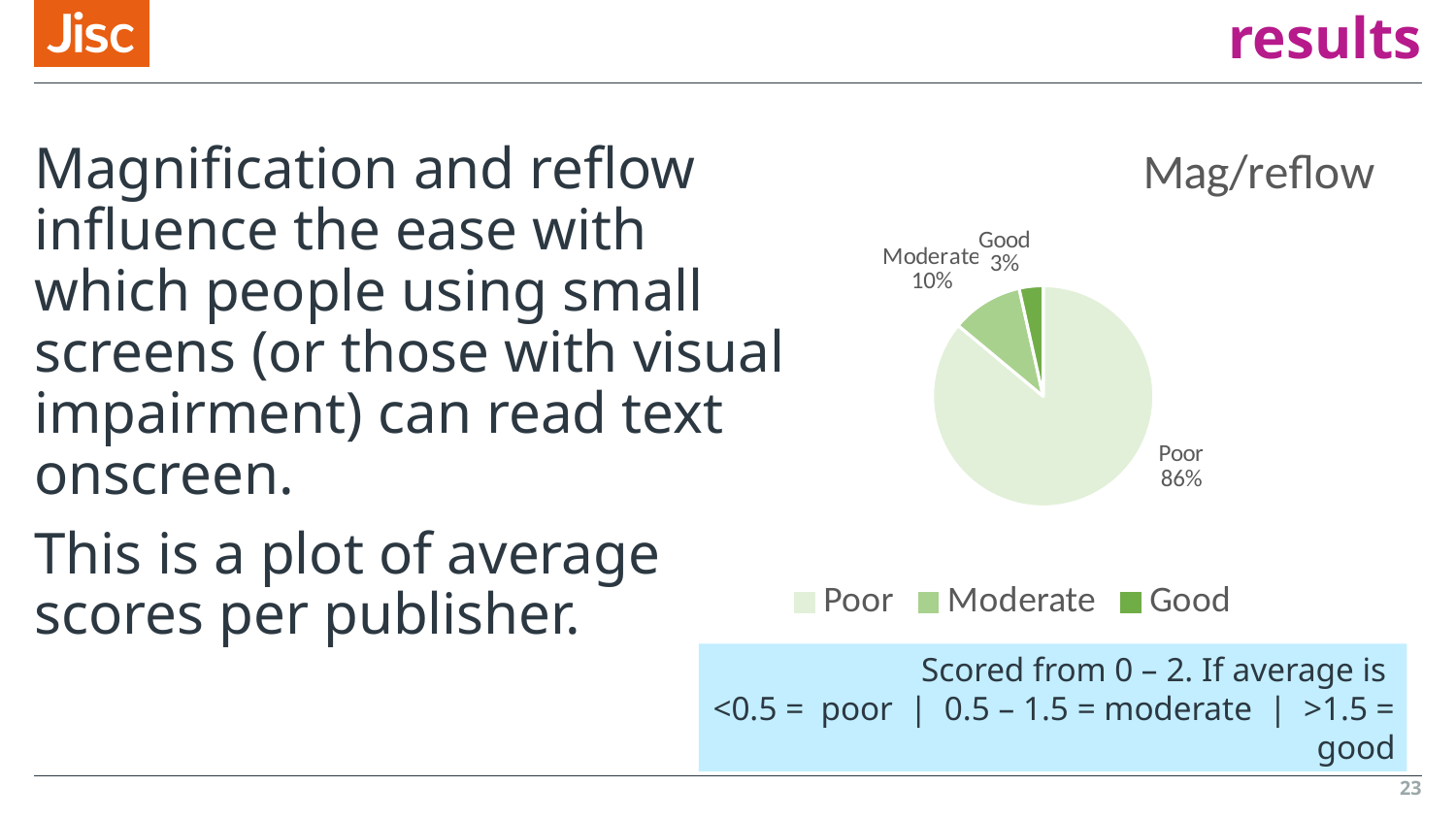
How many categories does the pie chart show? 3 What percentage of the pie is labelled Poor? 86% What is the difference in percentage points between the Moderate and Good slices? 7 How many entries does the legend list? 3 Which category has the smallest share of the pie? Good Which category has the largest share of the pie? Poor What kind of chart is shown on the slide? pie chart What is the title of the chart? Mag/reflow What percentage of the pie is labelled Moderate? 10% Which slice is larger, Moderate or Good? Moderate What percentage of the pie is labelled Good? 3% What is the difference in percentage points between the Poor and Moderate slices? 76